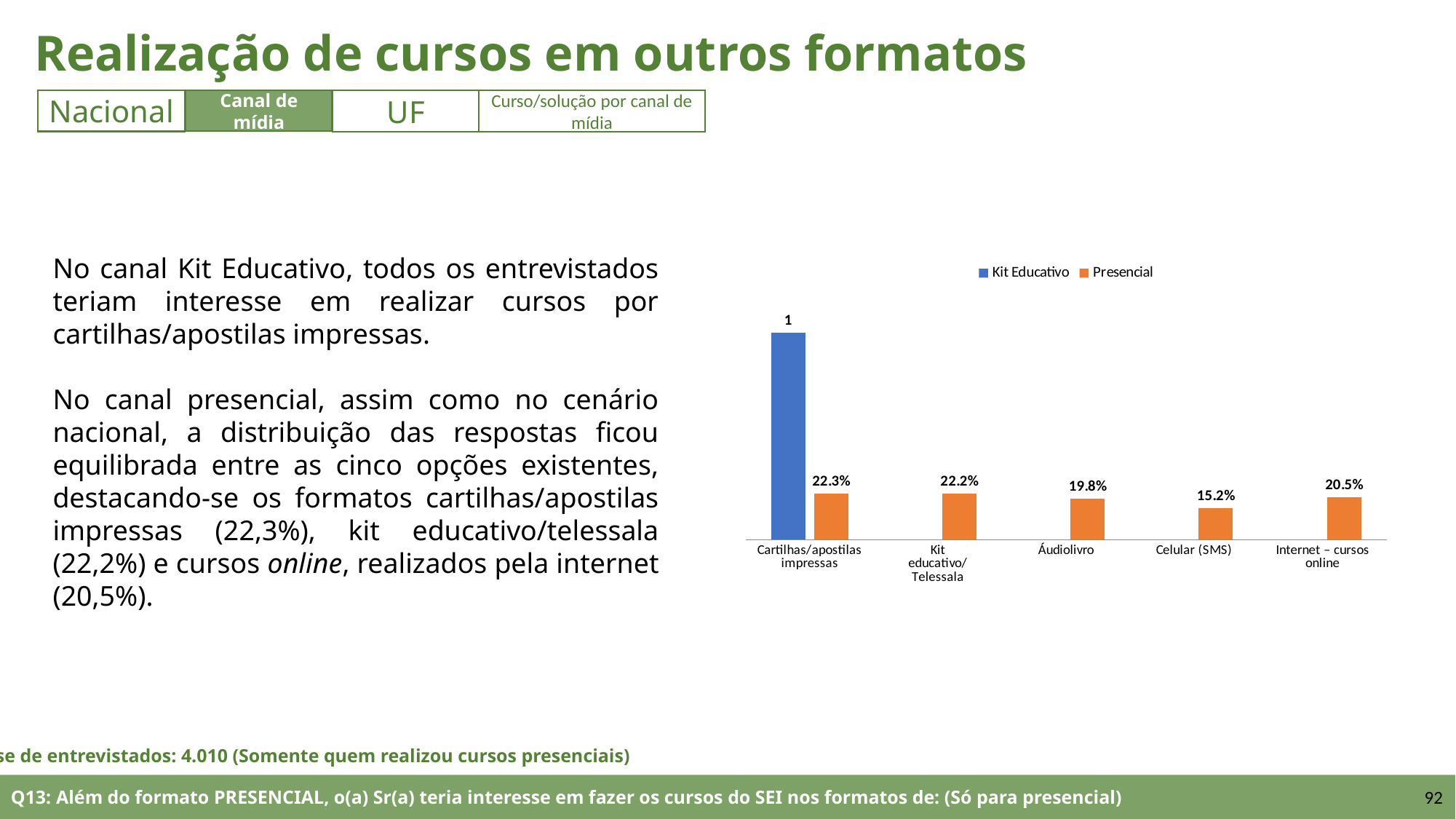
What is the Presencial value for Áudiolivro? 19.8% What kind of chart is shown on the slide? Bar chart How many series does the legend list? 2 What is the Presencial value for Cartilhas/apostilas impressas? 22.3% What is the difference between the Presencial values for Cartilhas/apostilas impressas and Celular (SMS)? 7.1% What is the Presencial value for Celular (SMS)? 15.2% Which category has the highest Presencial value? Cartilhas/apostilas impressas Which category has the lowest Presencial value? Celular (SMS) What is the Presencial value for Internet – cursos online? 20.5% What data label is shown on the Kit Educativo bar for Cartilhas/apostilas impressas? 1 Which has a larger Presencial value, Áudiolivro or Internet – cursos online? Internet – cursos online How many categories are shown on the x axis? 5